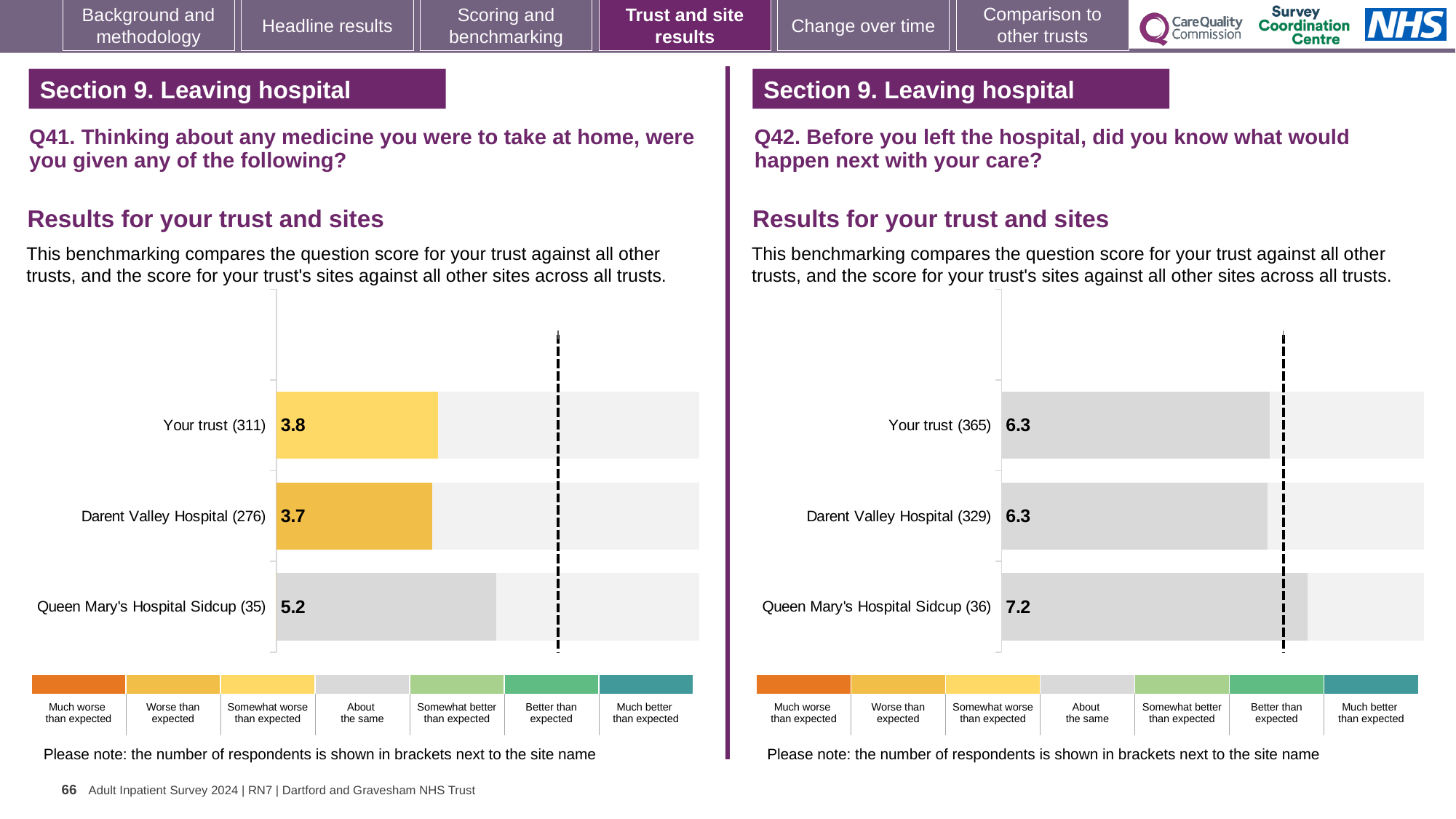
On the Q41 chart (left), what is the difference between the scores for Queen Mary's Hospital Sidcup and Your trust? 1.4 On the Q41 chart (left), what is the score for Your trust? 3.8 On the Q41 chart (left), which benchmark category does the colour of the Darent Valley Hospital bar correspond to in the legend? Worse than expected On the Q41 chart (left), what is the score for Darent Valley Hospital? 3.7 On the Q41 chart (left), how many respondents are shown in brackets for Queen Mary's Hospital Sidcup? 35 On the Q42 chart (right), which has the lower score, Your trust or Queen Mary's Hospital Sidcup? Your trust On the Q41 chart (left), how many bars are plotted? 3 What type of chart is used on the Q42 chart (right)? Bar chart On the Q41 chart (left), which site or trust has the highest score? Queen Mary's Hospital Sidcup On the Q42 chart (right), what is the score for Darent Valley Hospital? 6.3 On the Q42 chart (right), what is the score for Queen Mary's Hospital Sidcup? 7.2 On the Q42 chart (right), what is the difference between the scores for Queen Mary's Hospital Sidcup and Darent Valley Hospital? 0.9